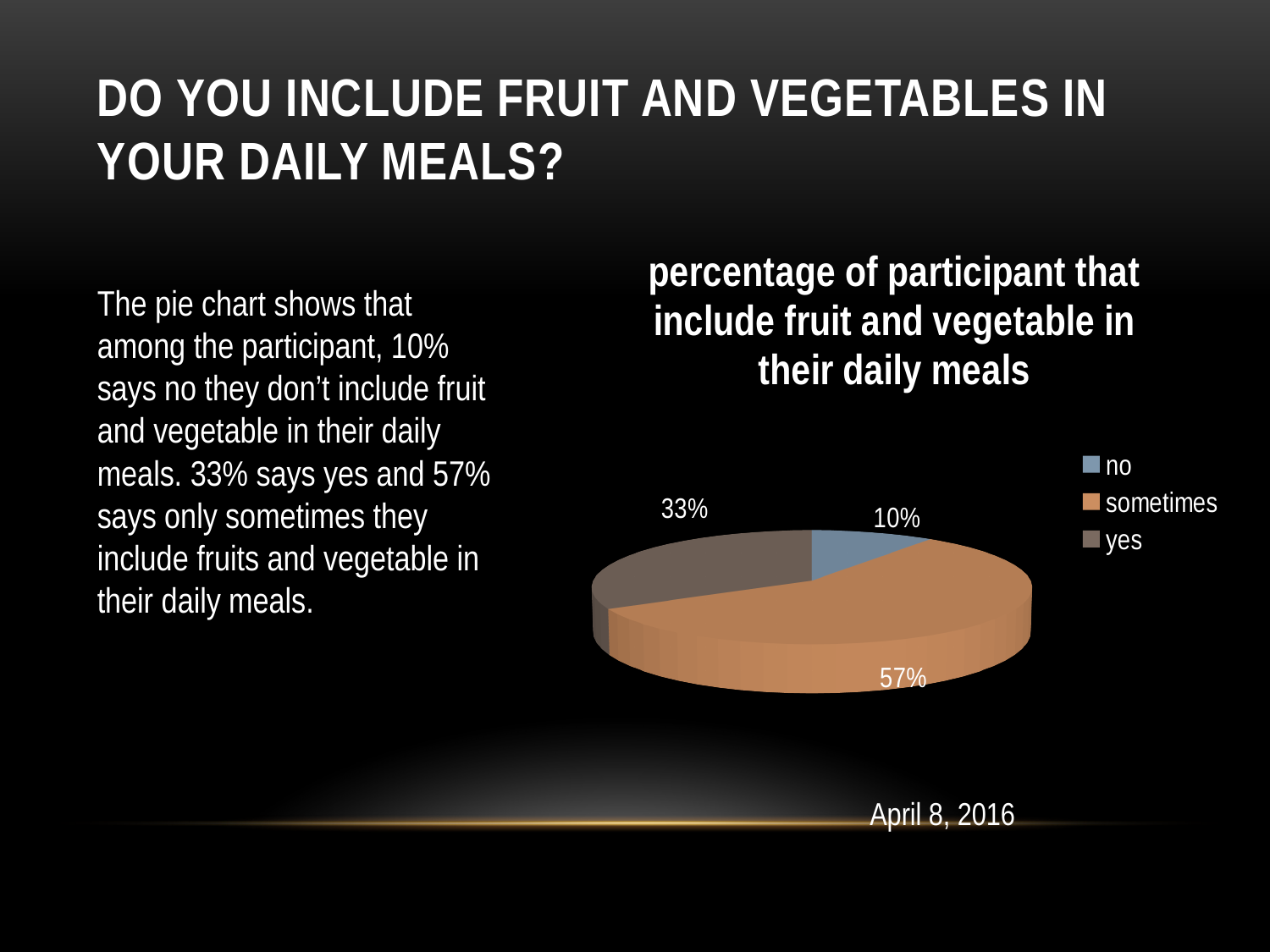
Which response has the largest share of the pie? sometimes Which is larger, the share for "yes" or the share for "no"? yes How many slices does the pie chart have? 3 What percentage of participants answered "yes"? 33% What percentage of participants answered "no"? 10% What kind of chart is shown on the slide? pie chart Which response has the smallest share of the pie? no What is the difference in percentage points between the "yes" and "no" slices? 23 What is the difference in percentage points between the "sometimes" and "yes" slices? 24 How many entries does the legend list? 3 What percentage of participants answered "sometimes"? 57% What is the title of the pie chart? percentage of participant that include fruit and vegetable in their daily meals